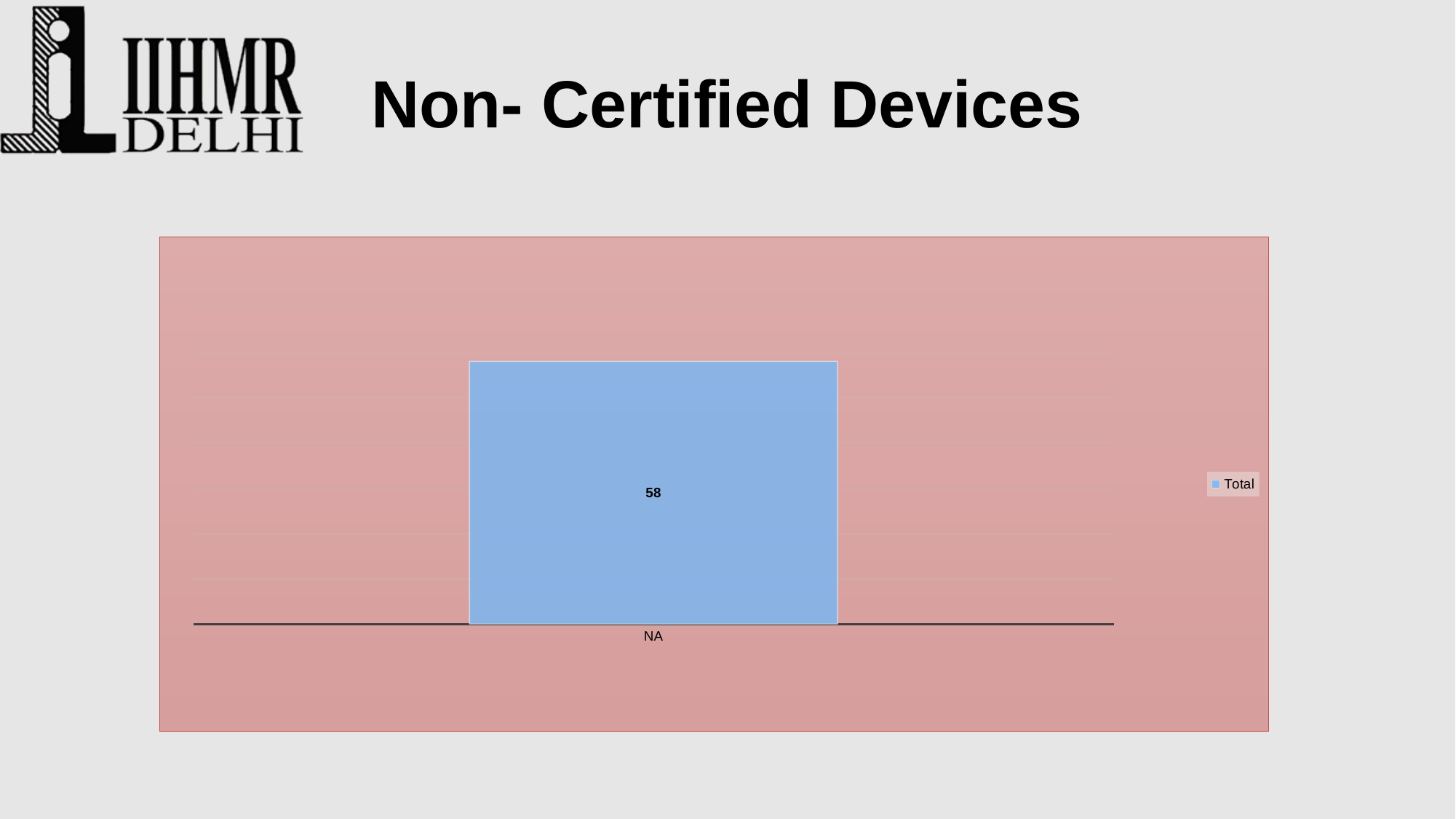
What is the label of the single category on the x axis? NA What series name appears in the chart legend? Total Which category has the highest value in the chart? NA How many series does the chart legend list? 1 What kind of chart is shown on the slide? bar chart What is the value of the Total bar for the category NA? 58 How many categories are plotted on the x axis of the chart? 1